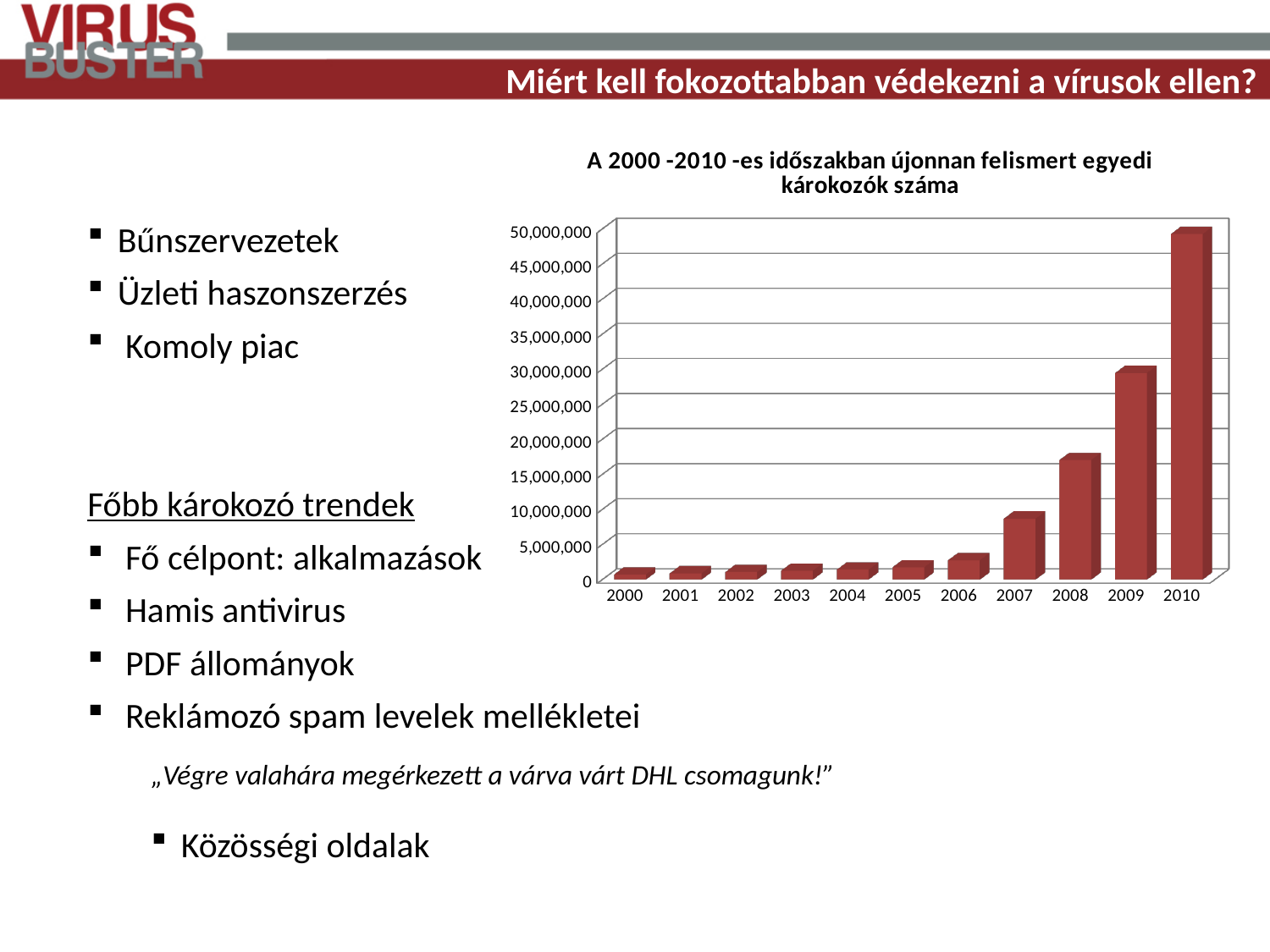
Is the value for 2009 greater or less than 25,000,000? greater Is the value for 2008 greater or less than 15,000,000? greater Is the value for 2010 greater or less than 45,000,000? greater What type of chart is shown on the slide? bar chart How many years are shown on the x axis of the chart? 11 Which year has the highest value in the chart? 2010 What is the highest value shown on the y axis of the chart? 50,000,000 Which is larger, the value for 2008 or the value for 2007? 2008 What is the title of the chart? A 2000 -2010 -es időszakban újonnan felismert egyedi károkozók száma Do the values generally rise or fall from 2000 to 2010? rise